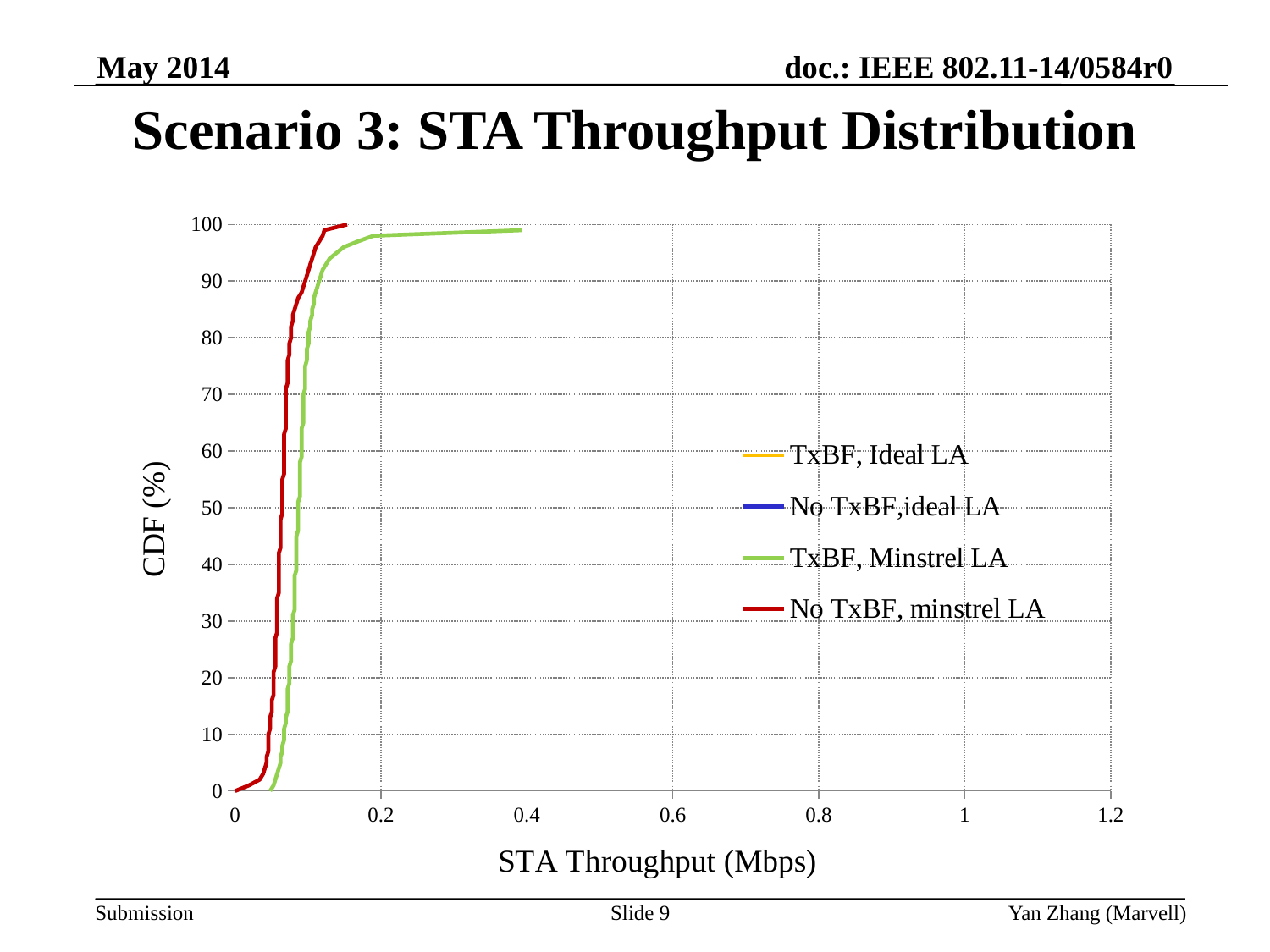
Is the largest STA throughput reached by the 'TxBF, Minstrel LA' curve greater or less than 0.2 Mbps? greater Is the largest STA throughput reached by the 'TxBF, Minstrel LA' curve greater or less than 0.6 Mbps? less Does the CDF rise or fall as STA throughput increases along the x axis? Rise Is the STA throughput at which the 'No TxBF, minstrel LA' curve reaches 100% CDF greater or less than 0.2 Mbps? less At 50% CDF, which curve lies at a higher STA throughput: 'TxBF, Minstrel LA' or 'No TxBF, minstrel LA'? TxBF, Minstrel LA How many series does the legend list? 4 What is the maximum value shown on the x axis? 1.2 What kind of chart is shown on the slide? Line chart What is the label of the x axis? STA Throughput (Mbps) What is the title of the chart on the slide? Scenario 3: STA Throughput Distribution